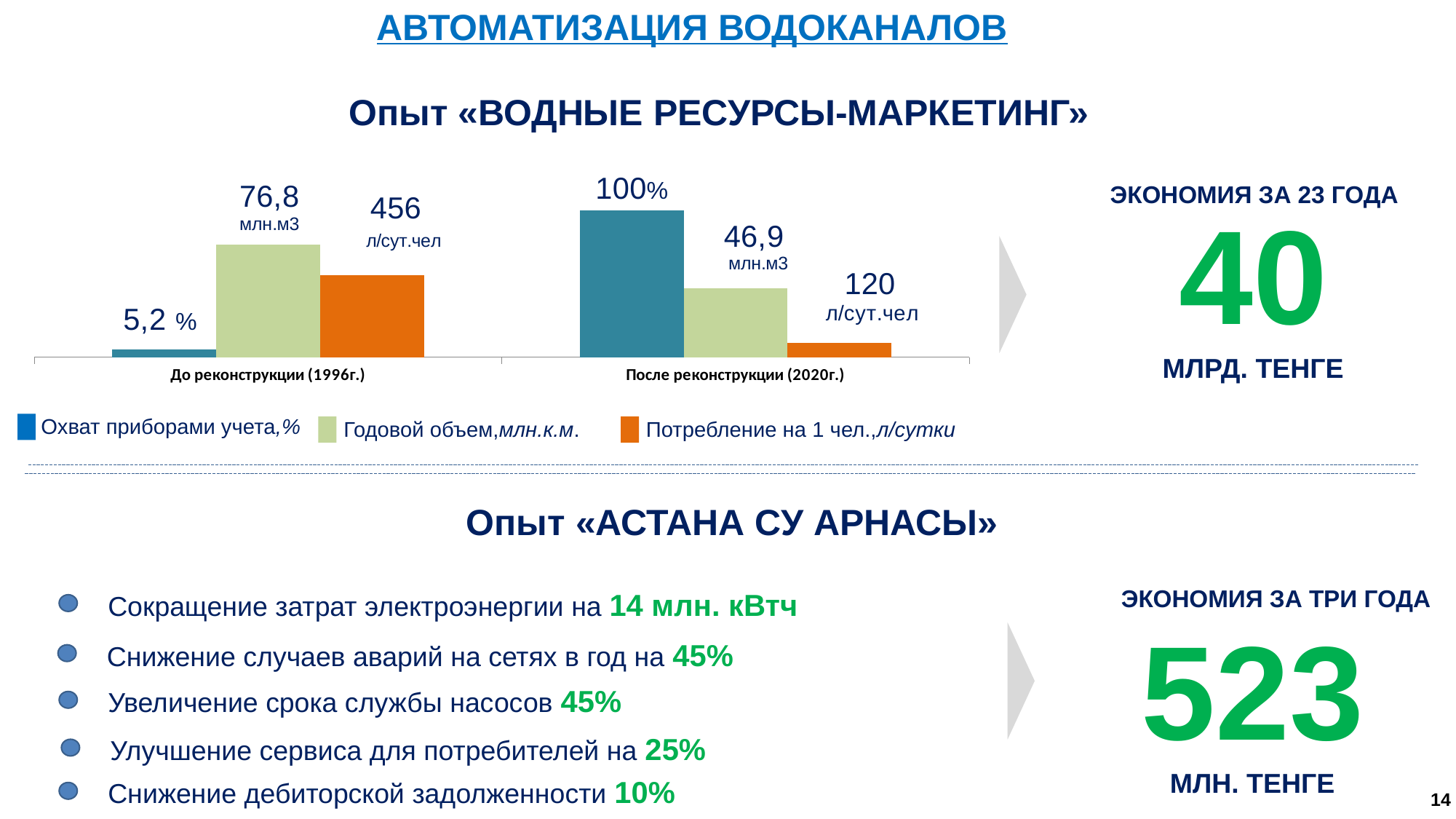
What is the value of Охват приборами учета for После реконструкции (2020г.)? 100% Which category has the higher value for Годовой объем: До реконструкции (1996г.) or После реконструкции (2020г.)? До реконструкции (1996г.) What kind of chart is shown on the slide? bar chart What is the value of Годовой объем for До реконструкции (1996г.)? 76,8 млн.м3 What is the value of Годовой объем for После реконструкции (2020г.)? 46,9 млн.м3 How many categories are shown on the x axis of the chart? 2 Which colour represents Потребление на 1 чел. in the chart legend? orange What is the value of Потребление на 1 чел. for После реконструкции (2020г.)? 120 л/сут.чел What is the value of Охват приборами учета for До реконструкции (1996г.)? 5,2 % By how much did Потребление на 1 чел. decrease from До реконструкции (1996г.) to После реконструкции (2020г.)? 336 л/сут.чел What is the value of Потребление на 1 чел. for До реконструкции (1996г.)? 456 л/сут.чел How many series does the chart legend list? 3